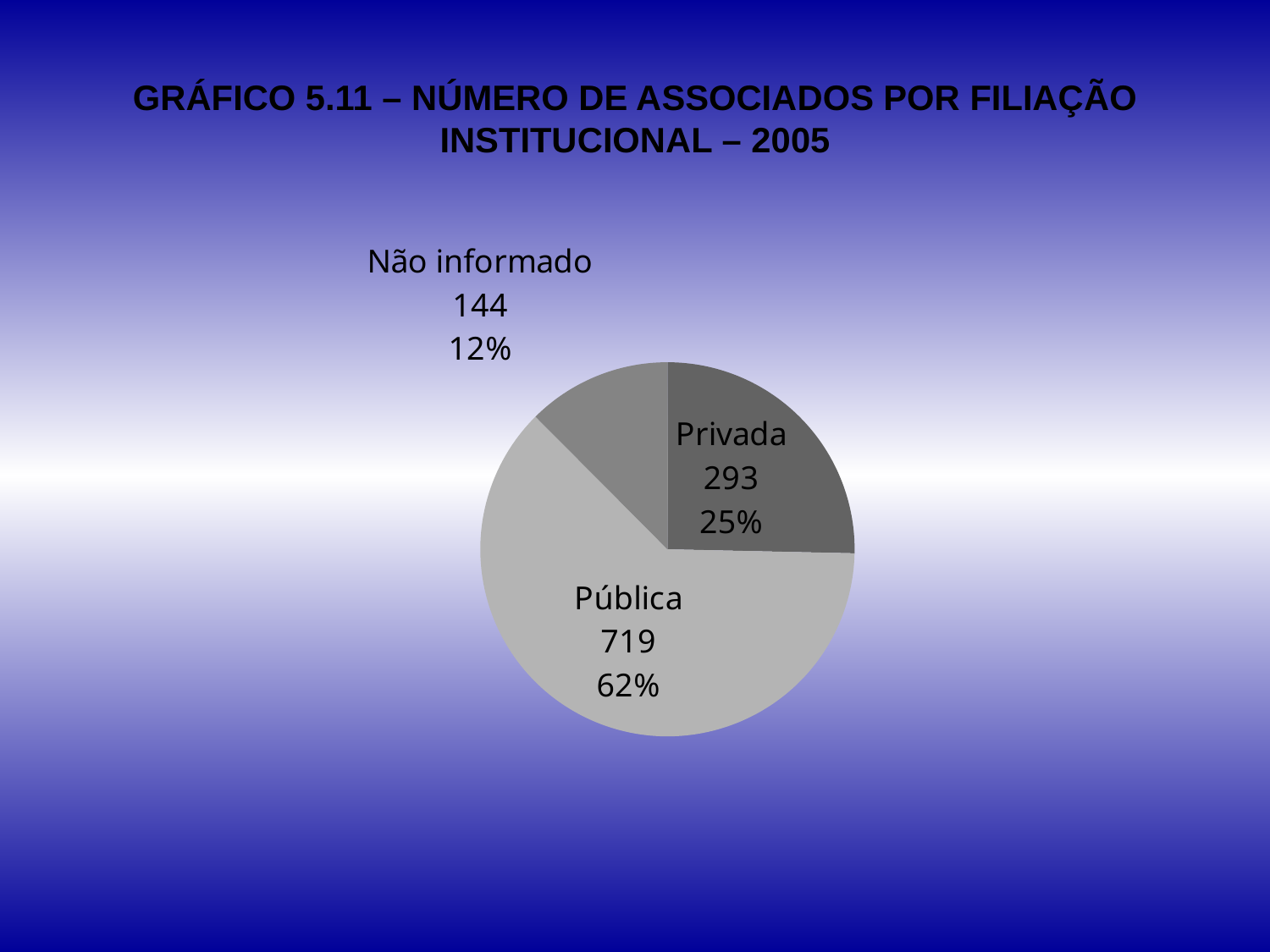
What share of the pie does Privada represent? 25% What is the number of associates for Privada? 293 Which is larger, the value for Privada or the value for Não informado? Privada What is the difference between the number of associates for Pública and Privada? 426 How many slices does the pie chart have? 3 What is the number of associates for Pública? 719 Which category has the largest number of associates? Pública Which category has the smallest number of associates? Não informado What type of chart is shown on the slide? pie chart What share of the pie does Pública represent? 62% What is the number of associates for Não informado? 144 What share of the pie does Não informado represent? 12%